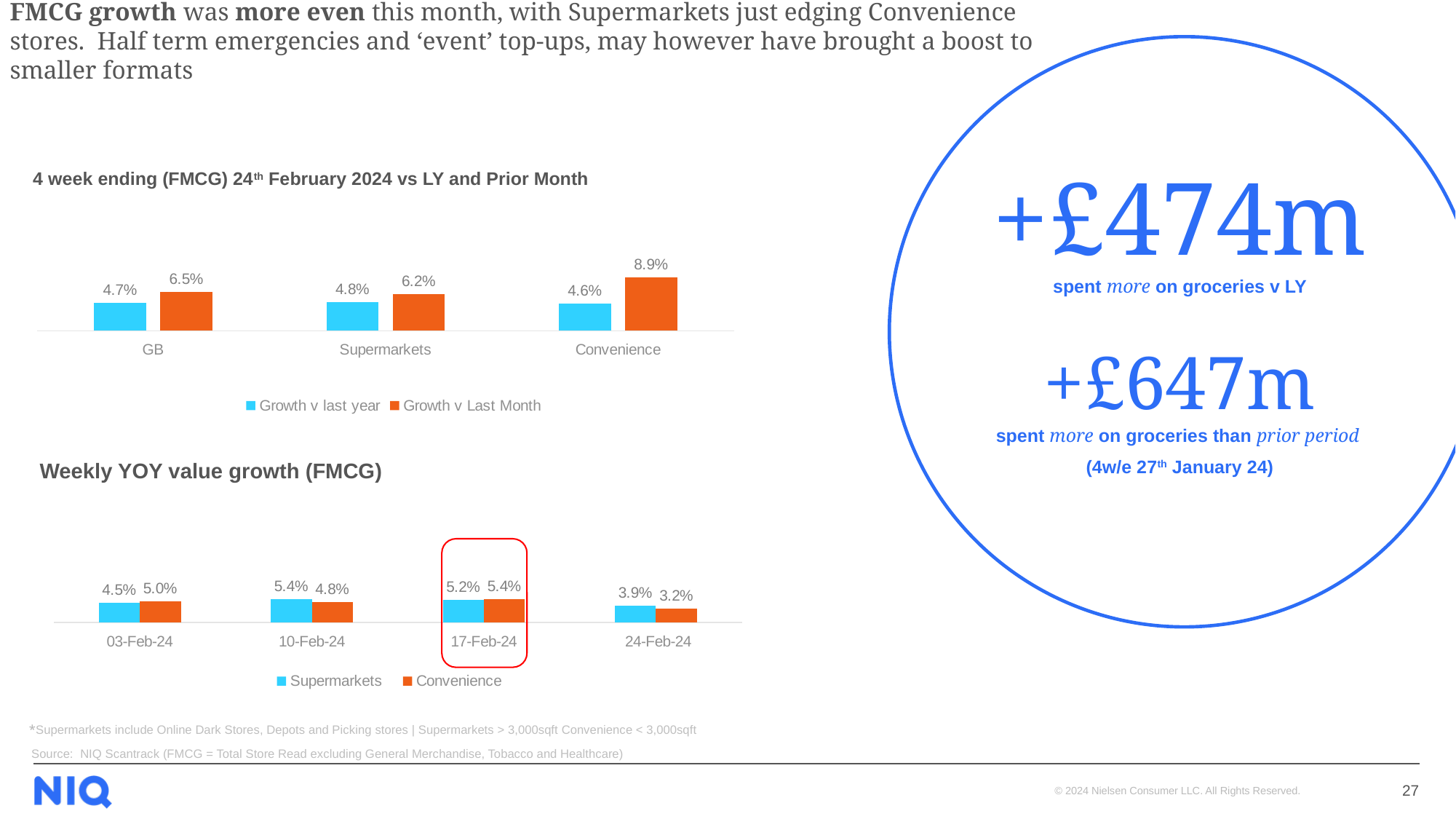
In the '4 week ending (FMCG) 24th February 2024 vs LY and Prior Month' chart, what is the difference between the Growth v Last Month and Growth v last year values for GB? 1.8% In the 'Weekly YOY value growth (FMCG)' chart, which week has the lowest Supermarkets value? 24-Feb-24 In the '4 week ending (FMCG) 24th February 2024 vs LY and Prior Month' chart, what is the Growth v Last Month value for Convenience? 8.9% In the 'Weekly YOY value growth (FMCG)' chart, what is the Supermarkets value for 10-Feb-24? 5.4% What kind of chart is the 'Weekly YOY value growth (FMCG)' chart? Bar chart In the '4 week ending (FMCG) 24th February 2024 vs LY and Prior Month' chart, what is the Growth v last year value for Supermarkets? 4.8% In the '4 week ending (FMCG) 24th February 2024 vs LY and Prior Month' chart, which category has the highest Growth v Last Month value? Convenience In the 'Weekly YOY value growth (FMCG)' chart, what is the Convenience value for 24-Feb-24? 3.2% In the 'Weekly YOY value growth (FMCG)' chart, which is larger for 17-Feb-24, Supermarkets or Convenience? Convenience In the 'Weekly YOY value growth (FMCG)' chart, how many weeks are shown on the x axis? 4 In the '4 week ending (FMCG) 24th February 2024 vs LY and Prior Month' chart, how many series does the legend list? 2 In the 'Weekly YOY value growth (FMCG)' chart, what is the difference between the Supermarkets and Convenience values for 03-Feb-24? 0.5%